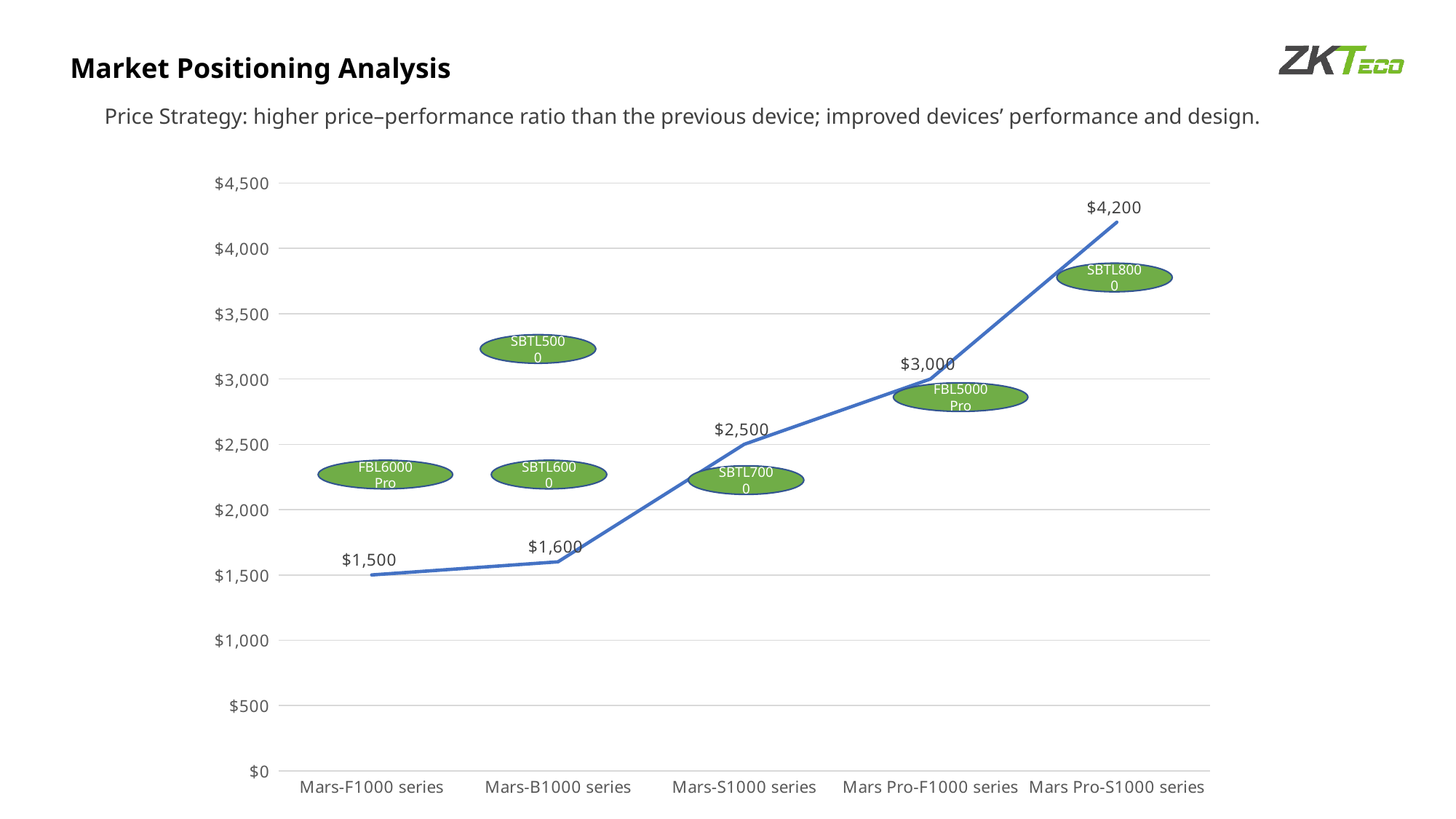
What is the difference between the values for Mars Pro-S1000 series and Mars Pro-F1000 series? $1,200 What kind of chart is shown on the slide? Line chart Which category has the lowest value? Mars-F1000 series How many categories are plotted on the x axis? 5 Do the values rise or fall from left to right along the x axis? Rise What is the value for Mars-S1000 series? $2,500 Which is larger, the value for Mars-S1000 series or Mars-B1000 series? Mars-S1000 series What is the value for Mars Pro-F1000 series? $3,000 What is the value for Mars-F1000 series? $1,500 What is the value for Mars-B1000 series? $1,600 Which category has the highest value? Mars Pro-S1000 series What is the value for Mars Pro-S1000 series? $4,200